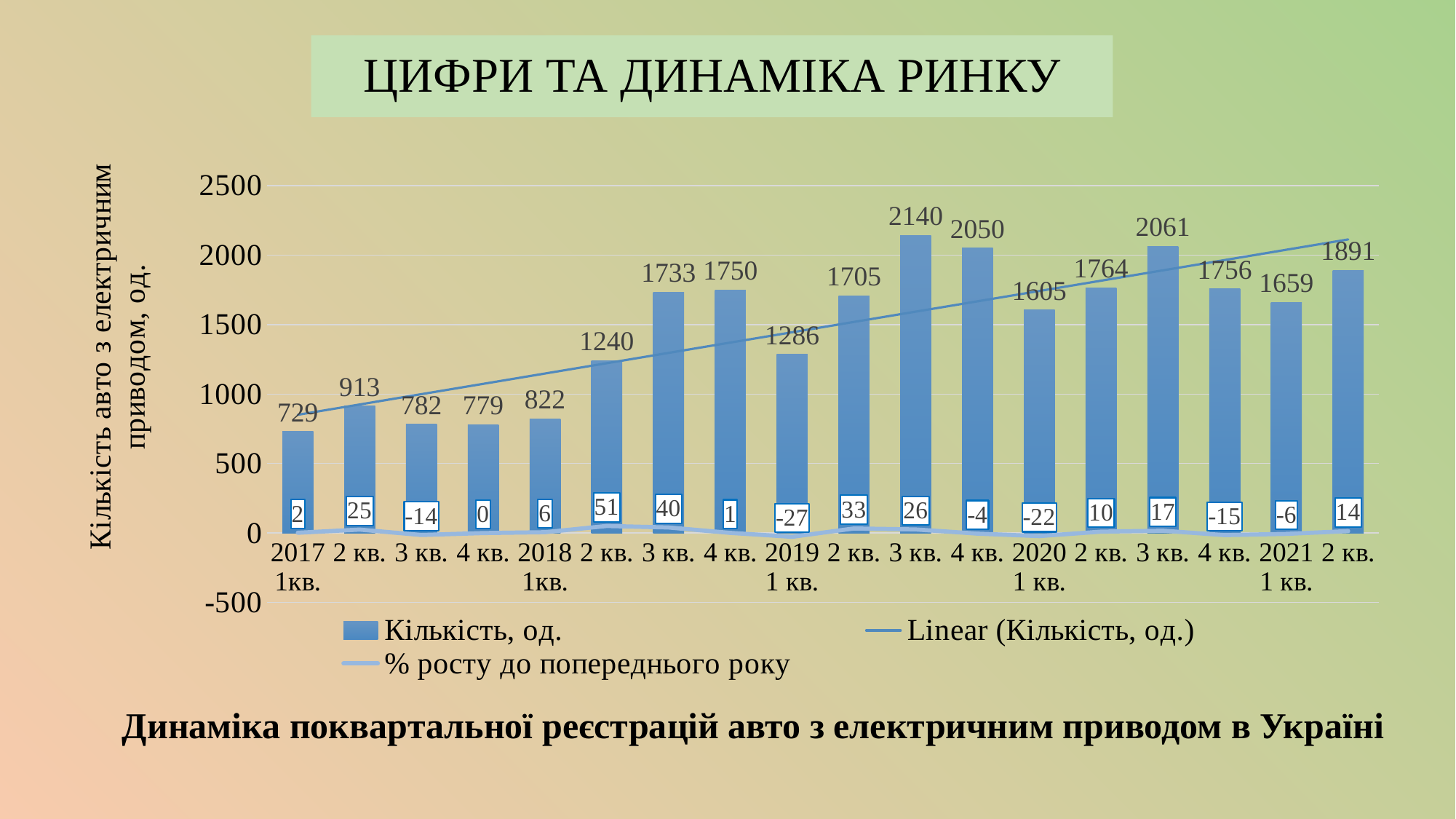
What is the difference in Кількість, од. between 2021 2 кв. and 2021 1 кв.? 232 Which quarter has the lowest value of Кількість, од.? 2017 1кв. How many entries does the legend list? 3 What is the lowest value of % росту до попереднього року shown? -27 Which quarter has the highest value of Кількість, од.? 2019 3 кв. What is the value of Кількість, од. for 2019 3 кв.? 2140 What is the value of % росту до попереднього року for 2018 2 кв.? 51 Which is larger, the Кількість, од. value for 2020 3 кв. or for 2019 4 кв.? 2020 3 кв. Is the Кількість, од. value for 2018 1кв. greater or less than 1000? less What kind of chart is used for the Кількість, од. series? bar chart How many quarters are shown on the x axis? 18 What is the value of Кількість, од. for 2017 1кв.? 729